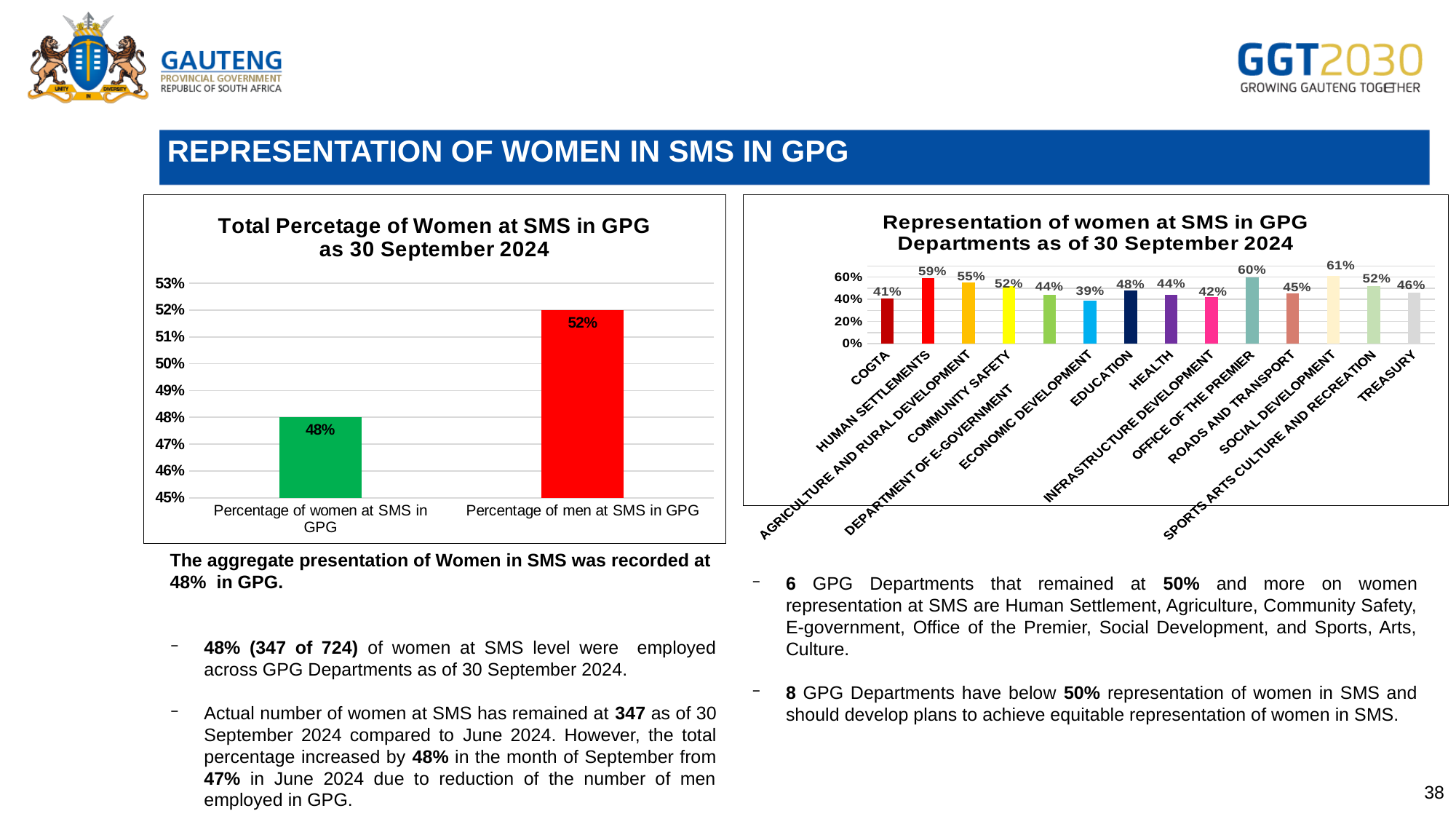
In the left chart, what is the percentage of women at SMS in GPG? 48% In the right chart, what is the representation of women at SMS for Human Settlements? 59% In the right chart, what is the representation of women at SMS for Treasury? 46% In the left chart, what is the difference between the percentage of men and the percentage of women at SMS in GPG? 4% In the right chart, what is the difference between Agriculture and Rural Development and Infrastructure Development? 13% In the right chart, which department has the lowest representation of women at SMS? Economic Development In the right chart, which is higher: Office of the Premier or COGTA? Office of the Premier In the right chart, which department has the highest representation of women at SMS? Social Development What type of chart is the left chart titled 'Total Percetage of Women at SMS in GPG as 30 September 2024'? Bar chart In the right chart, what is the value for Education? 48% In the left chart, what is the percentage of men at SMS in GPG? 52% In the right chart, how many departments are shown? 14